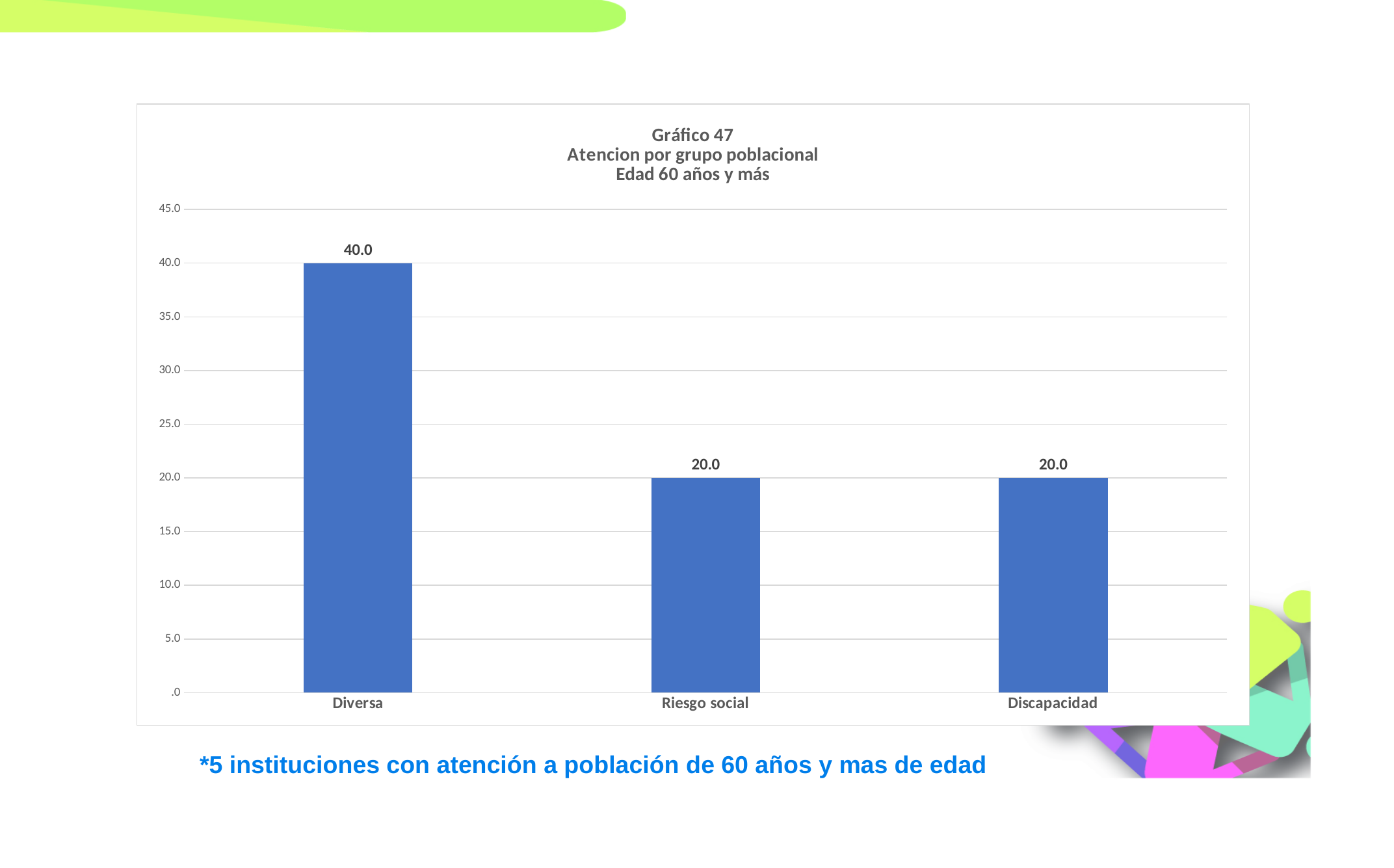
How many categories are shown on the x axis? 3 Which is larger, the value for Diversa or the value for Discapacidad? Diversa What is the highest value shown on the y axis? 45.0 What kind of chart is shown on the slide? bar chart What is the value for Diversa? 40.0 Is the value for Riesgo social greater or less than 25.0? less What is the difference between the values for Diversa and Riesgo social? 20.0 What is the value for Riesgo social? 20.0 Is the value for Diversa greater or less than 35.0? greater What is the value for Discapacidad? 20.0 Which category has the highest value? Diversa What is the chart number given in the title? Gráfico 47